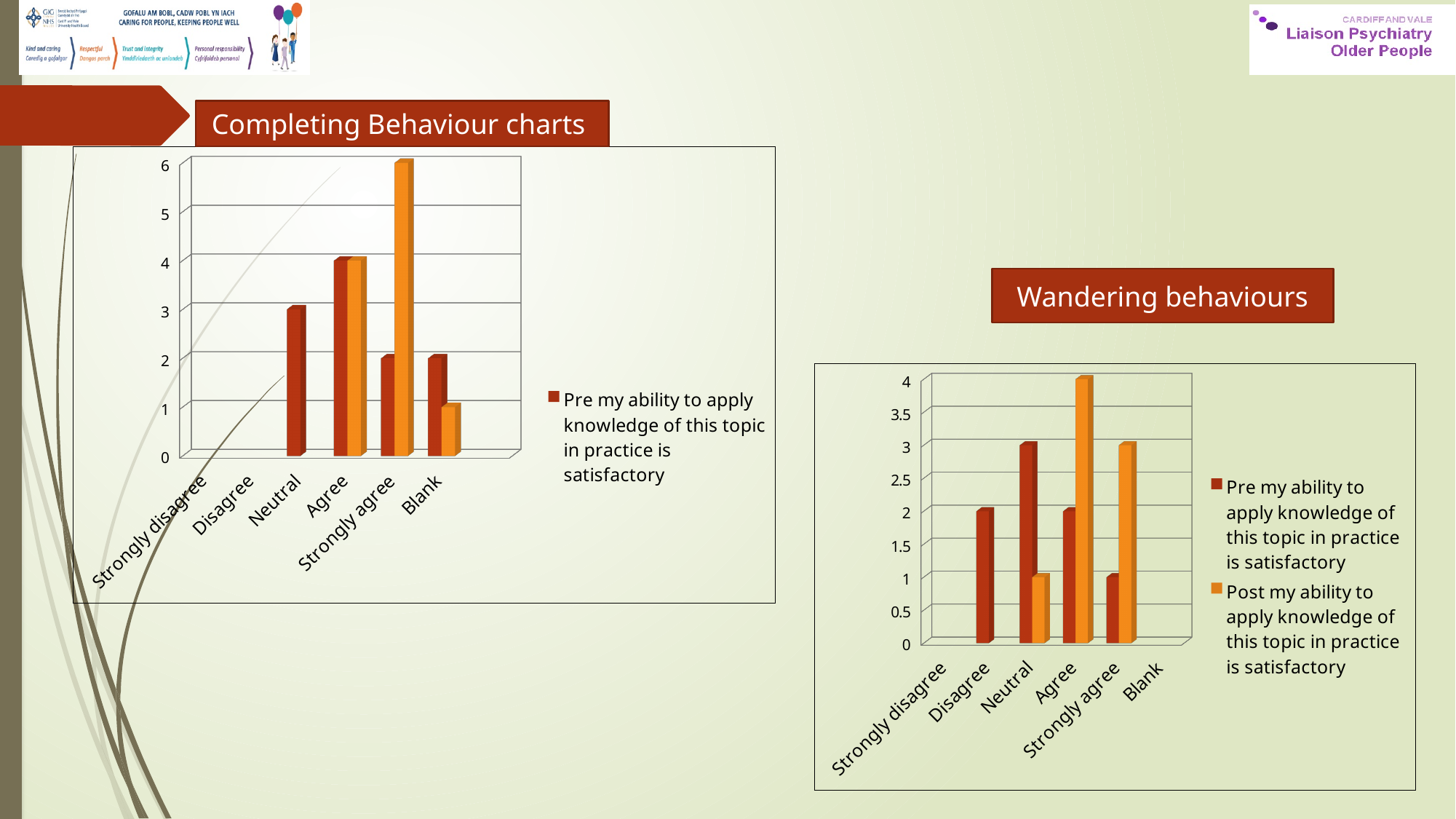
In the 'Wandering behaviours' chart, which is larger for Neutral: the 'Pre' bar or the 'Post' bar? Pre In the 'Wandering behaviours' chart, is the 'Pre' value for Strongly agree greater or less than 1.5? less In the 'Completing Behaviour charts' chart, is the value of the 'Pre' bar for Neutral greater or less than 2? greater In the 'Wandering behaviours' chart, which category has the tallest bar? Agree What type of chart is the 'Completing Behaviour charts' chart? bar chart In the 'Wandering behaviours' chart, is the 'Post' value for Agree greater or less than 3.5? greater How many series does the legend of the 'Completing Behaviour charts' chart list? 1 In the 'Completing Behaviour charts' chart, which category has the tallest bar? Strongly agree In the 'Completing Behaviour charts' chart, which is larger for Blank: the 'Pre' bar or the orange bar? Pre How many series does the legend of the 'Wandering behaviours' chart list? 2 How many categories are shown on the x axis of the 'Wandering behaviours' chart? 6